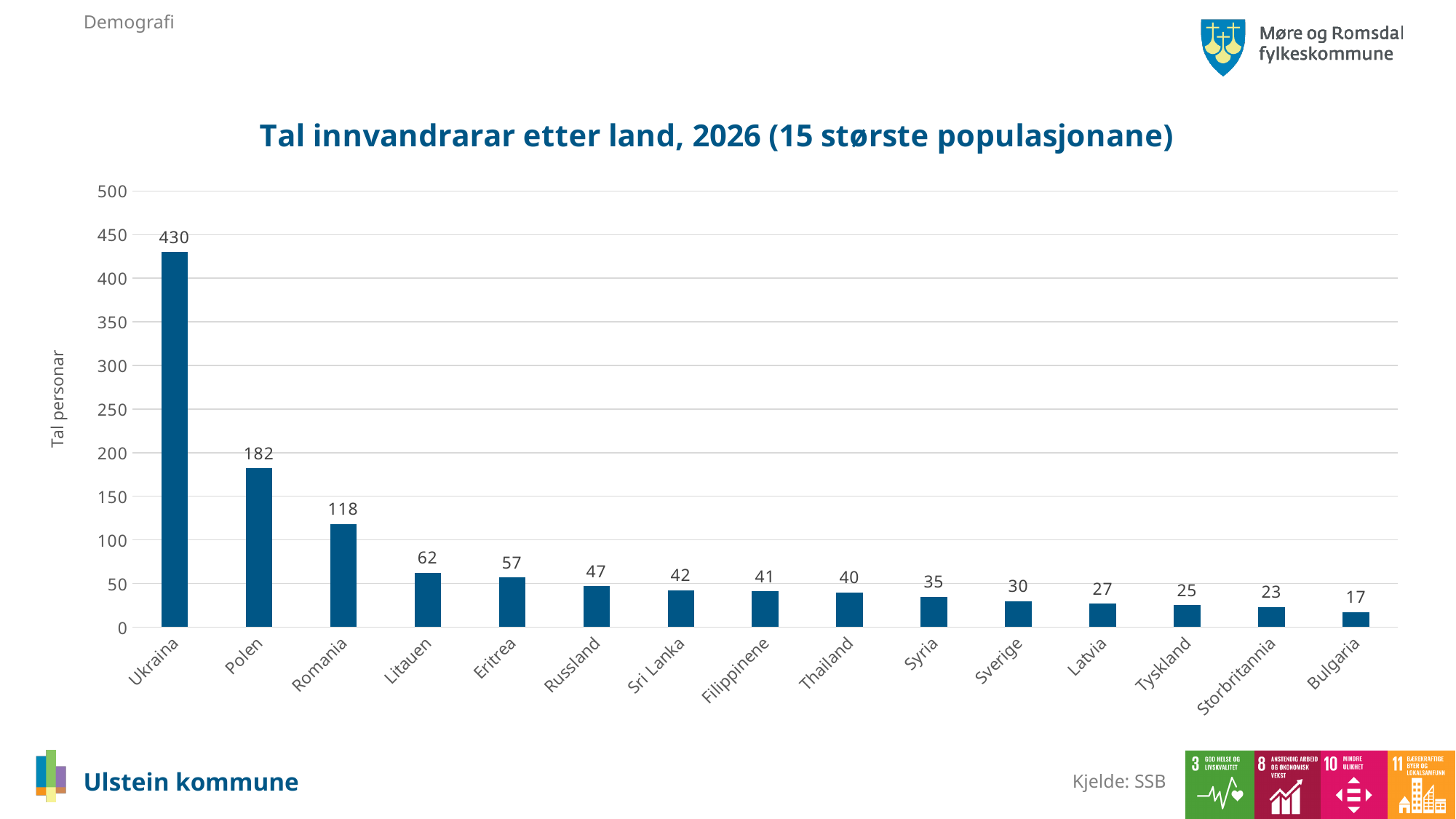
Is the value for Polen greater or less than 150? greater What is the value for Ukraina? 430 Which is larger, the value for Syria or the value for Sverige? Syria What is the value for Romania? 118 How many countries are shown on the chart? 15 Which country has the lowest value? Bulgaria What is the title of the chart? Tal innvandrarar etter land, 2026 (15 største populasjonane) Which country has the highest value? Ukraina What is the difference between the values for Litauen and Eritrea? 5 What is the difference between the values for Ukraina and Polen? 248 What kind of chart is this? bar chart What is the value for Thailand? 40